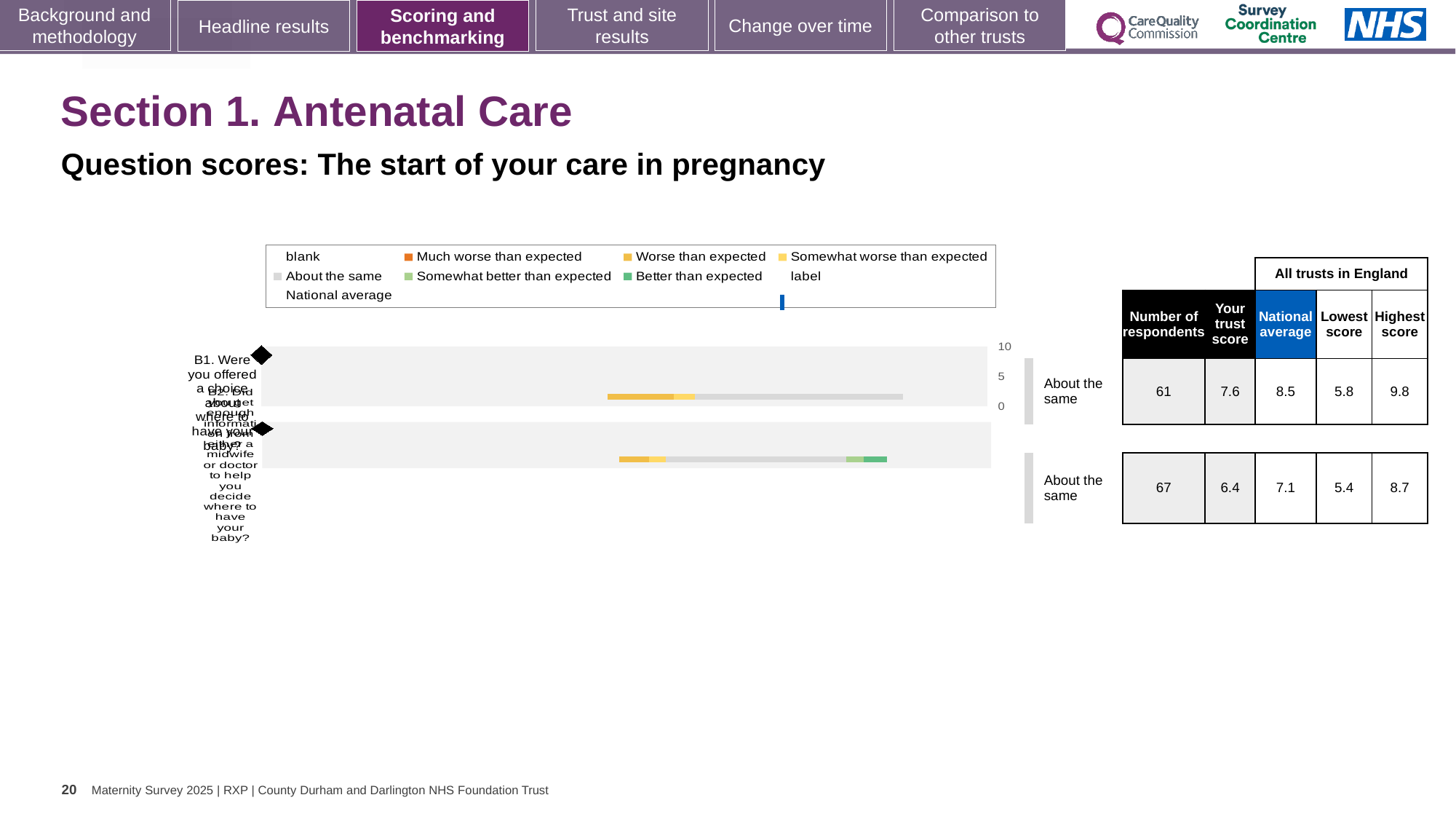
What is the maximum value shown on the chart's score axis? 10 What benchmark category is shown next to the bar for question B1? About the same What is the 'Your trust score' for B1 (Were you offered a choice about where to have your baby?)? 7.6 What is the difference between the national average and the trust score for question B1? 0.9 How many respondents answered question B2? 67 Which question has the higher national average? B1 What is the highest score among all trusts in England for question B1? 9.8 Which question has the higher trust score, B1 or B2? B1 What kind of chart is used to show the question scores on this slide? bar chart What is the national average for B2 (Did you get enough information from either a midwife or doctor to help you decide where to have your baby?)? 7.1 How many questions are plotted in the chart? 2 What is the difference between the highest and lowest scores for question B2? 3.3